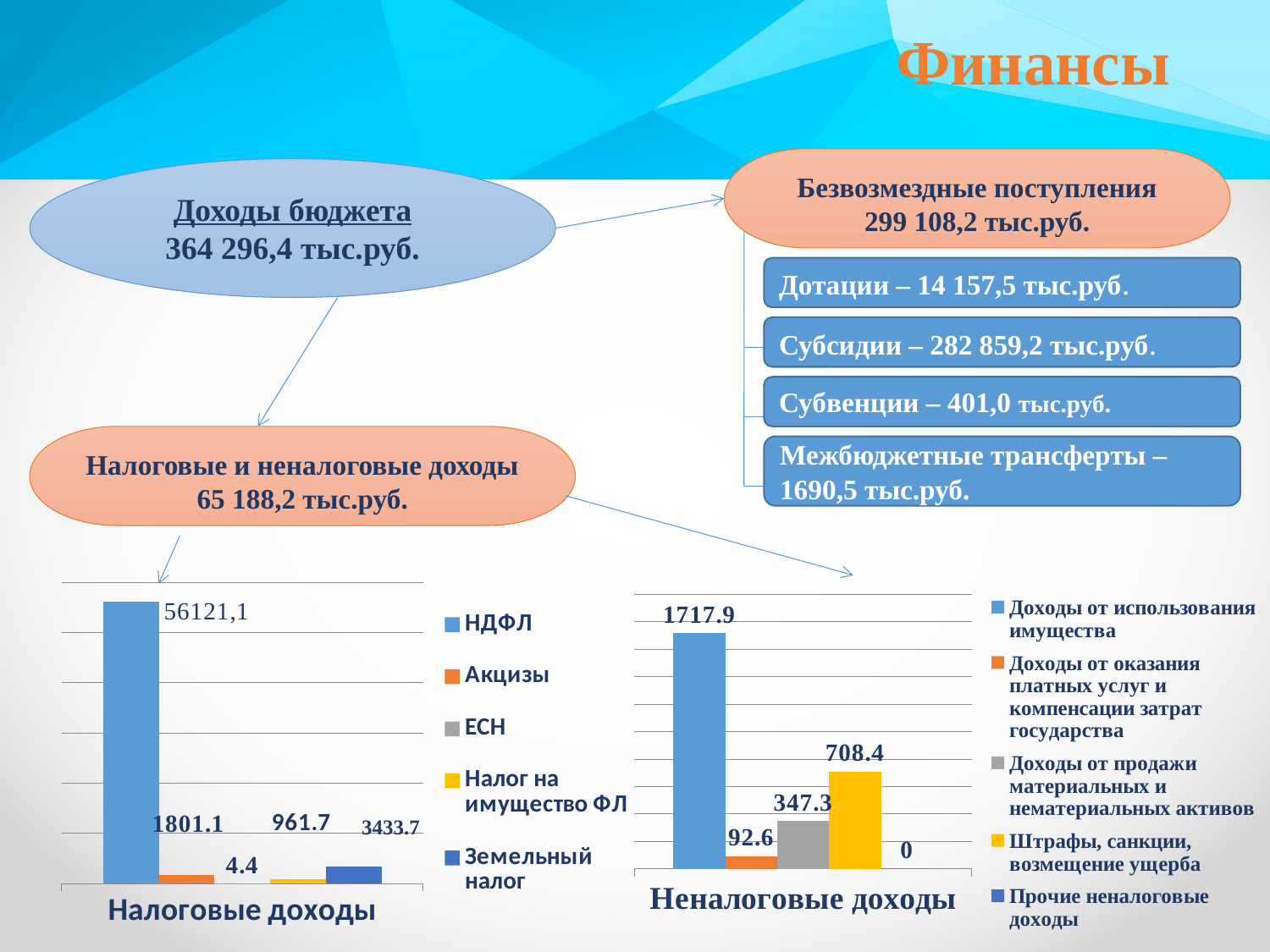
In the chart titled "Налоговые доходы", what is the value for НДФЛ? 56121,1 In the chart titled "Налоговые доходы", what is the value for Земельный налог? 3433.7 In the chart titled "Неналоговые доходы", what is the value for Прочие неналоговые доходы? 0 In the chart titled "Неналоговые доходы", which series has the highest value? Доходы от использования имущества In the chart titled "Неналоговые доходы", what is the difference between Доходы от использования имущества and Штрафы, санкции, возмещение ущерба? 1009.5 In the chart titled "Налоговые доходы", which series has the lowest value? ЕСН What type of chart is the chart titled "Неналоговые доходы"? Bar chart In the chart titled "Налоговые доходы", what is the difference between Земельный налог and Акцизы? 1632.6 In the chart titled "Неналоговые доходы", what is the value for Доходы от продажи материальных и нематериальных активов? 347.3 In the chart titled "Налоговые доходы", which is larger: Акцизы or Налог на имущество ФЛ? Акцизы How many series does the legend of the chart titled "Налоговые доходы" list? 5 In the chart titled "Неналоговые доходы", what is the value for Штрафы, санкции, возмещение ущерба? 708.4